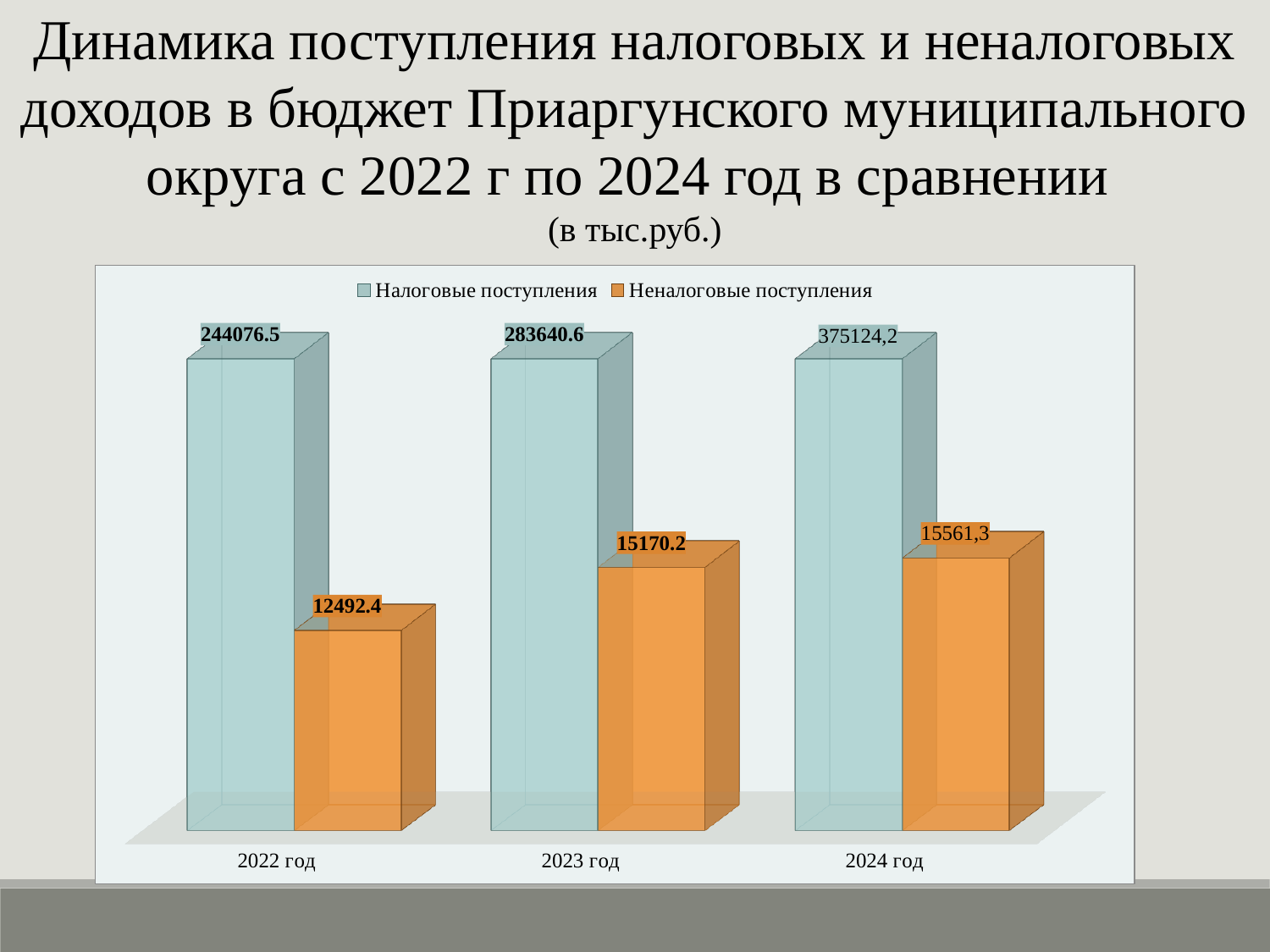
How many series does the legend list? 2 What is the value of Налоговые поступления for 2024 год? 375124,2 Which is larger in 2022 год: Налоговые поступления or Неналоговые поступления? Налоговые поступления What kind of chart is shown on the slide? Bar chart What is the difference between Неналоговые поступления in 2023 год and 2022 год? 2677.8 In which year is Налоговые поступления the highest? 2024 год What is the difference between Налоговые поступления in 2023 год and 2022 год? 39564.1 How many years are shown on the x axis? 3 In which year is Неналоговые поступления the lowest? 2022 год What is the value of Налоговые поступления for 2022 год? 244076.5 What is the value of Неналоговые поступления for 2023 год? 15170.2 What is the value of Неналоговые поступления for 2024 год? 15561,3